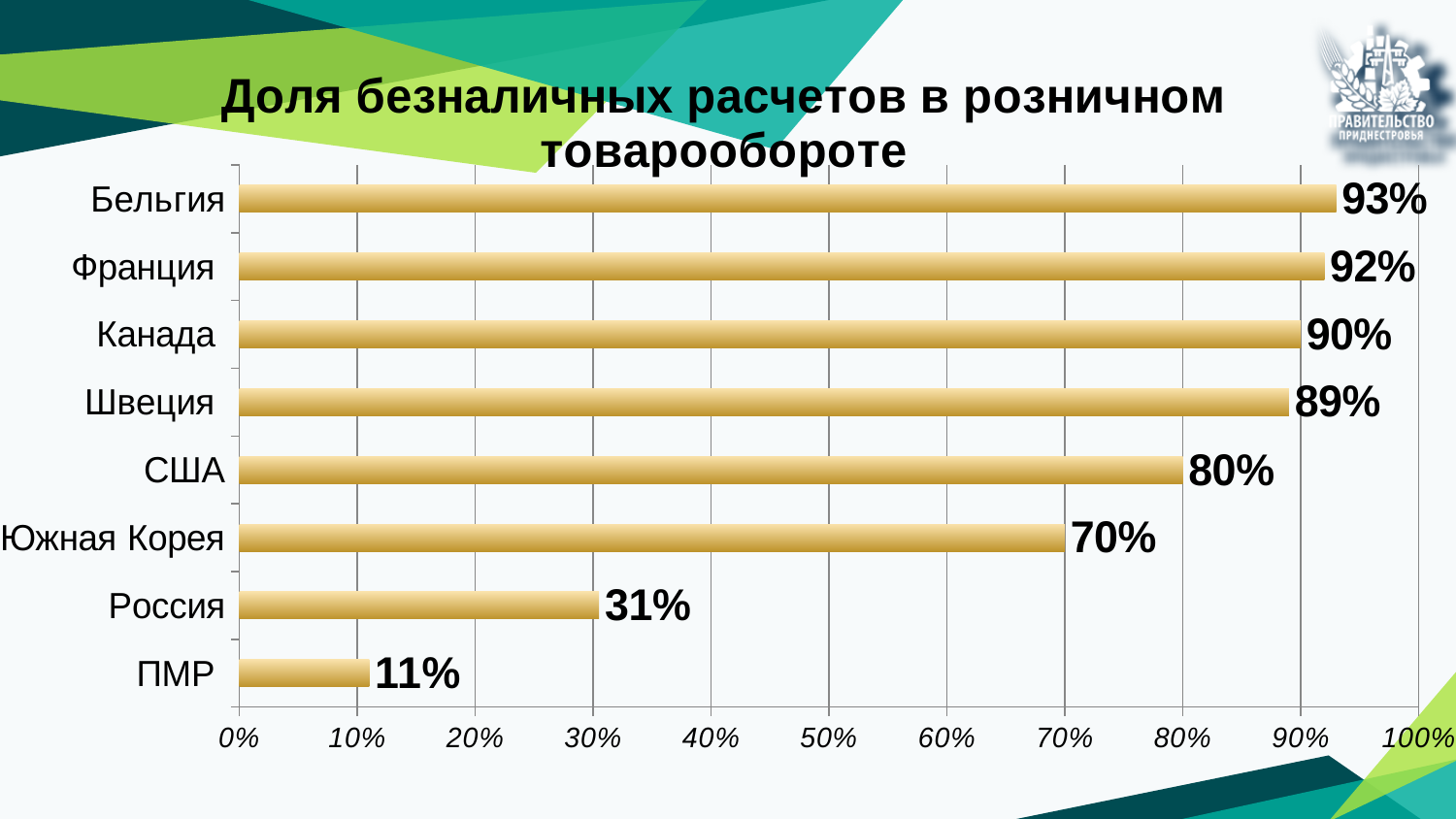
Is the value for Швеция greater or less than 80%? greater What is the value for ПМР? 11% How many categories are shown in the chart? 8 What is the value for США? 80% Which is larger, the value for Россия or the value for Южная Корея? Южная Корея What is the value for Россия? 31% What kind of chart is shown on the slide? bar chart What is the difference between the values for Бельгия and ПМР? 82% What is the title of the chart? Доля безналичных расчетов в розничном товарообороте What is the difference between the values for США and Южная Корея? 10% Which category has the lowest value? ПМР Which category has the highest value? Бельгия